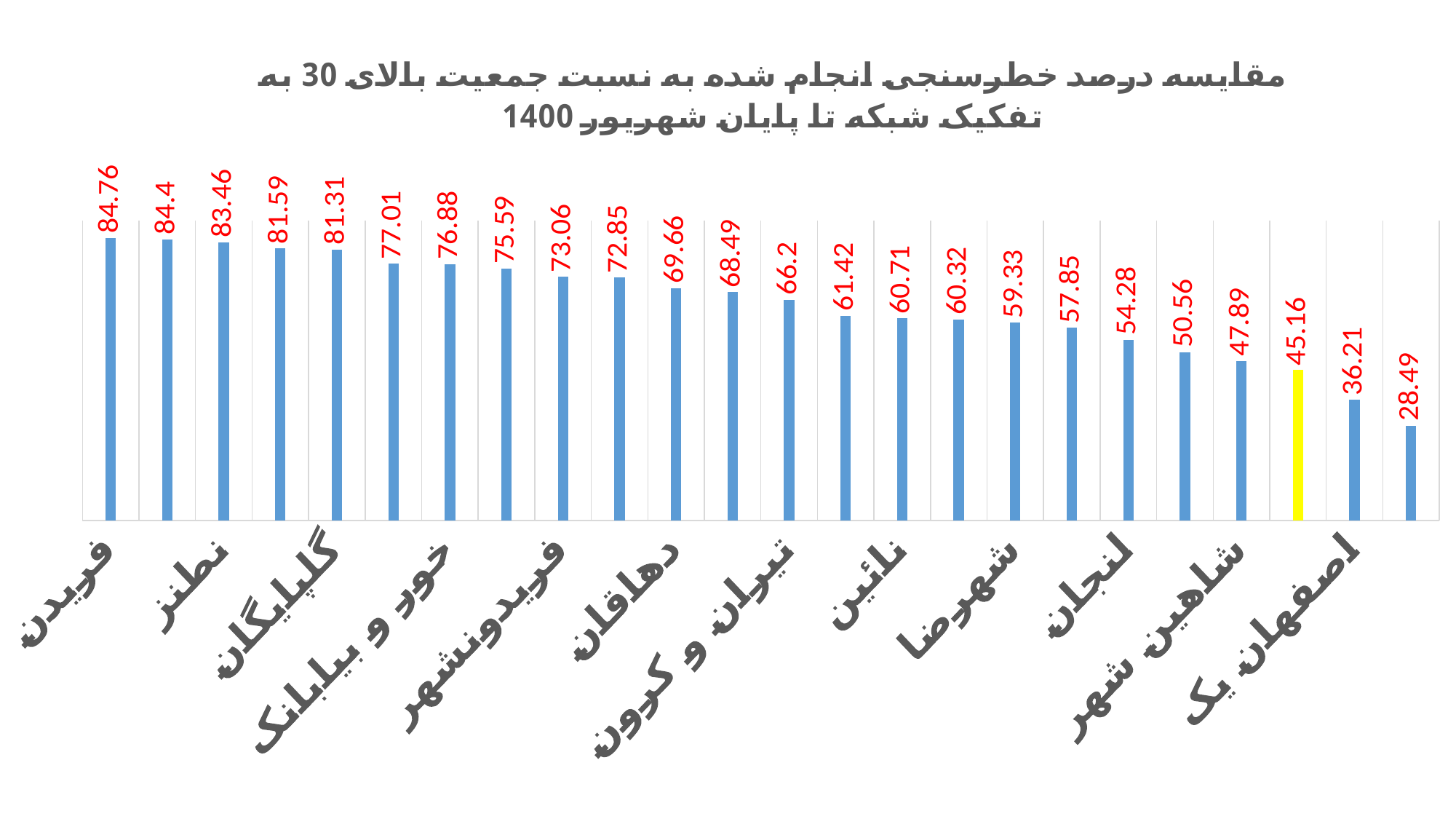
What is the value of the bar for فریدن? 84.76 What kind of chart is shown on the slide? bar chart What is the difference between the highest value (84.76) and the lowest value (28.49)? 56.27 What is the value of the yellow-highlighted bar? 45.16 What is the value of the bar for نطنز? 83.46 How many bars are plotted in the chart? 24 Which is larger, the value for فریدن or the value of the yellow bar? فریدن What is the value of the bar for اصفهان یک? 36.21 What is the lowest value shown in the chart? 28.49 What colour are the bars other than the single highlighted one? blue Do the bar values rise or fall from left to right across the chart? fall What is the highest value shown in the chart? 84.76